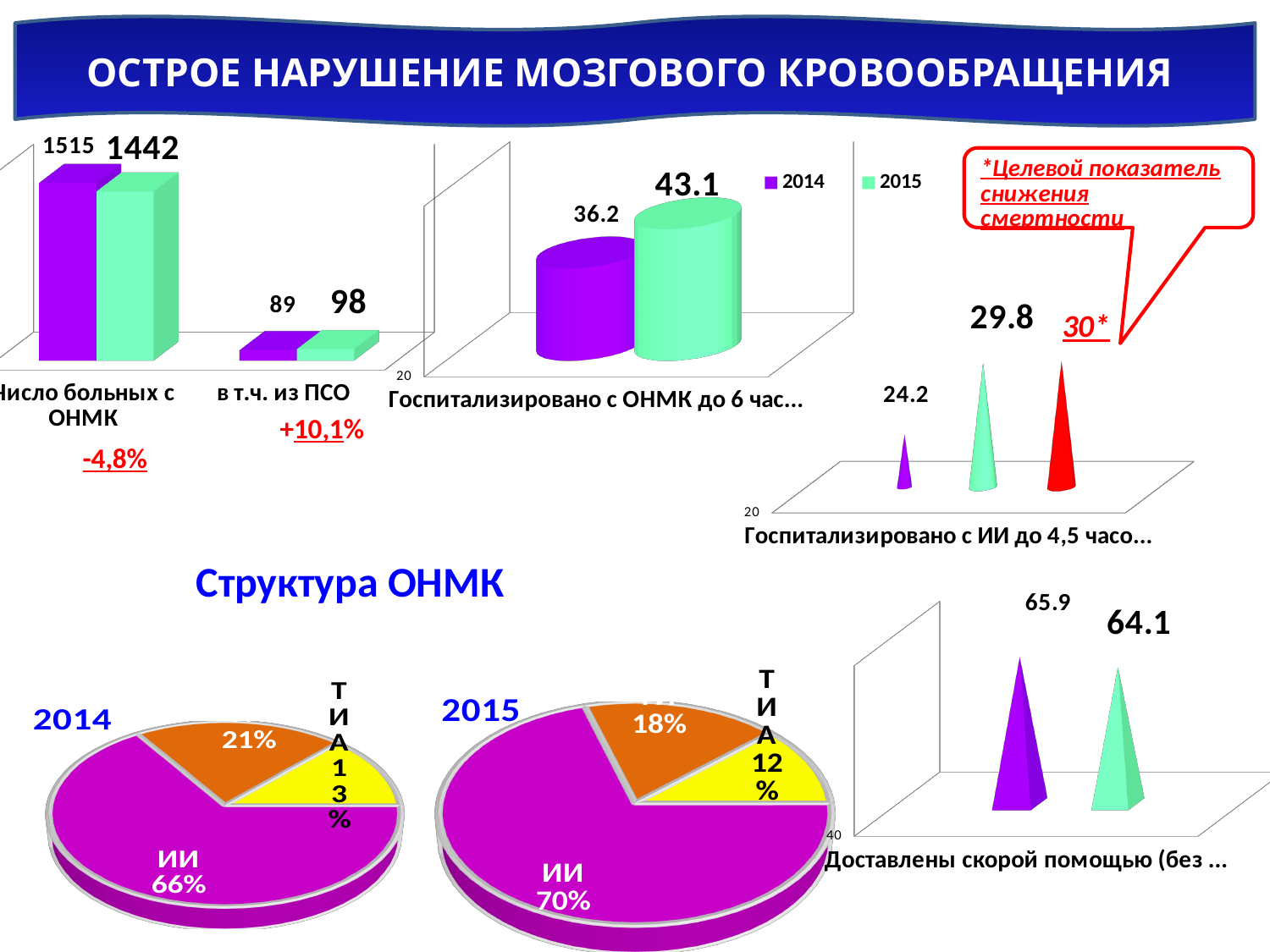
In the chart "Госпитализировано с ИИ до 4,5 часо...", what is the target value shown on the red cone? 30* In the top-left bar chart, what is the 2014 value for "Число больных с ОНМК"? 1515 In the top-left bar chart, what is the 2015 value for "в т.ч. из ПСО"? 98 In the 2015 pie chart under "Структура ОНМК", what share does ТИА have? 12% In the top-left bar chart, what is the 2015 value for "Число больных с ОНМК"? 1442 In the top-left bar chart, what is the difference between the 2014 and 2015 values for "Число больных с ОНМК"? 73 In the chart "Госпитализировано с ИИ до 4,5 часо...", what is the value of the smallest (purple) cone? 24.2 In the chart "Доставлены скорой помощью (без ...", what is the value of the purple (2014) cone? 65.9 In the 2014 pie chart under "Структура ОНМК", what share does ИИ have? 66% In the chart "Госпитализировано с ОНМК до 6 час...", which year has the larger value, 2014 or 2015? 2015 In the chart "Госпитализировано с ОНМК до 6 час...", how many series does the legend list? 2 In the chart "Госпитализировано с ОНМК до 6 час...", what is the value for 2015? 43.1